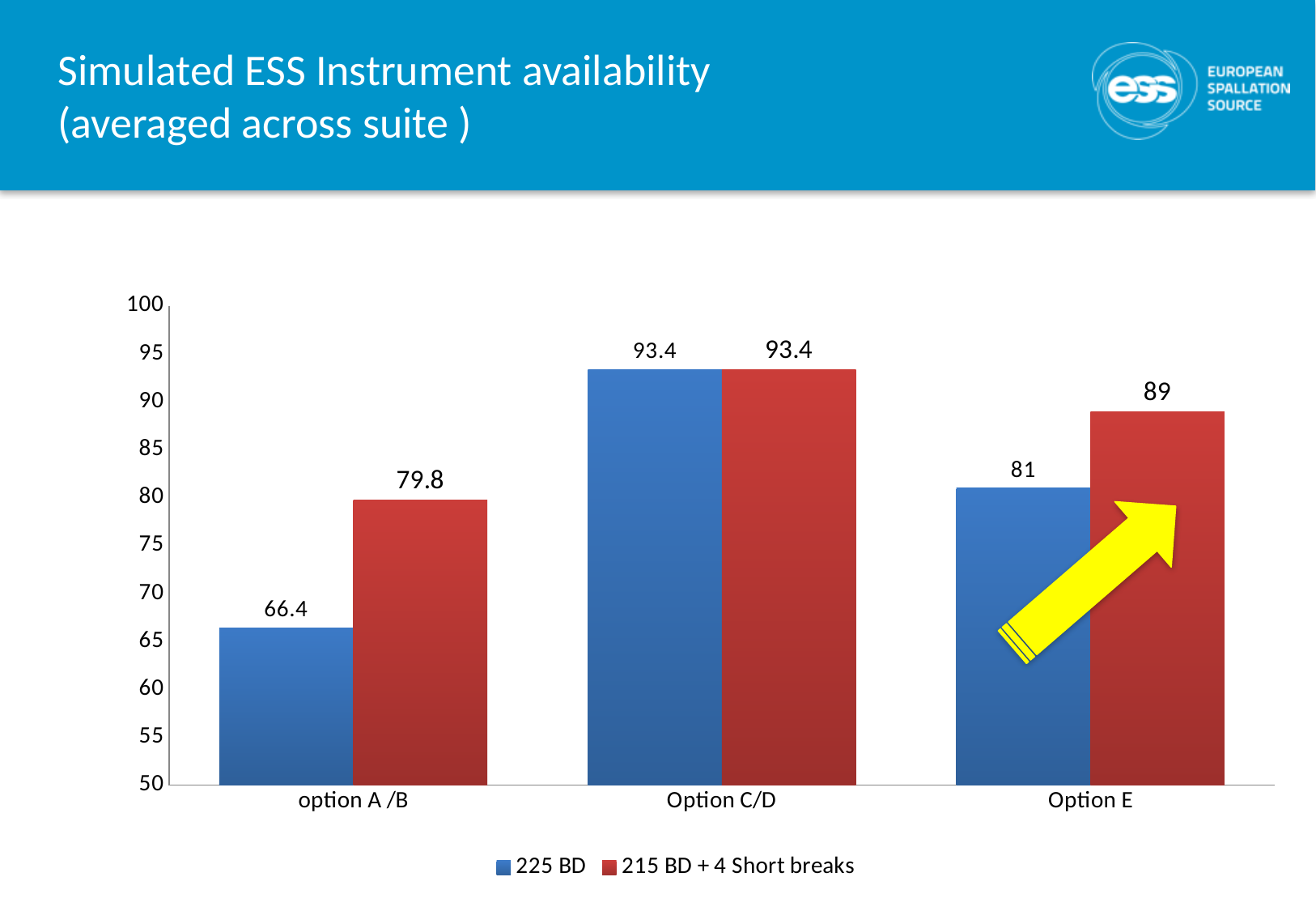
How many categories are shown on the x axis? 3 How many series does the legend list? 2 What is the difference between the two series' values for option A /B? 13.4 Which category has the lowest value in the 215 BD + 4 Short breaks series? option A /B What is the value for option A /B in the 215 BD + 4 Short breaks series? 79.8 What is the value for Option E in the 215 BD + 4 Short breaks series? 89 What is the value for option A /B in the 225 BD series? 66.4 What kind of chart is shown on the slide? Bar chart Which is larger for Option E: the 225 BD value or the 215 BD + 4 Short breaks value? 215 BD + 4 Short breaks What is the value for Option C/D in the 225 BD series? 93.4 Which category has the highest value in the 225 BD series? Option C/D What is the difference between the 215 BD + 4 Short breaks value and the 225 BD value for Option E? 8